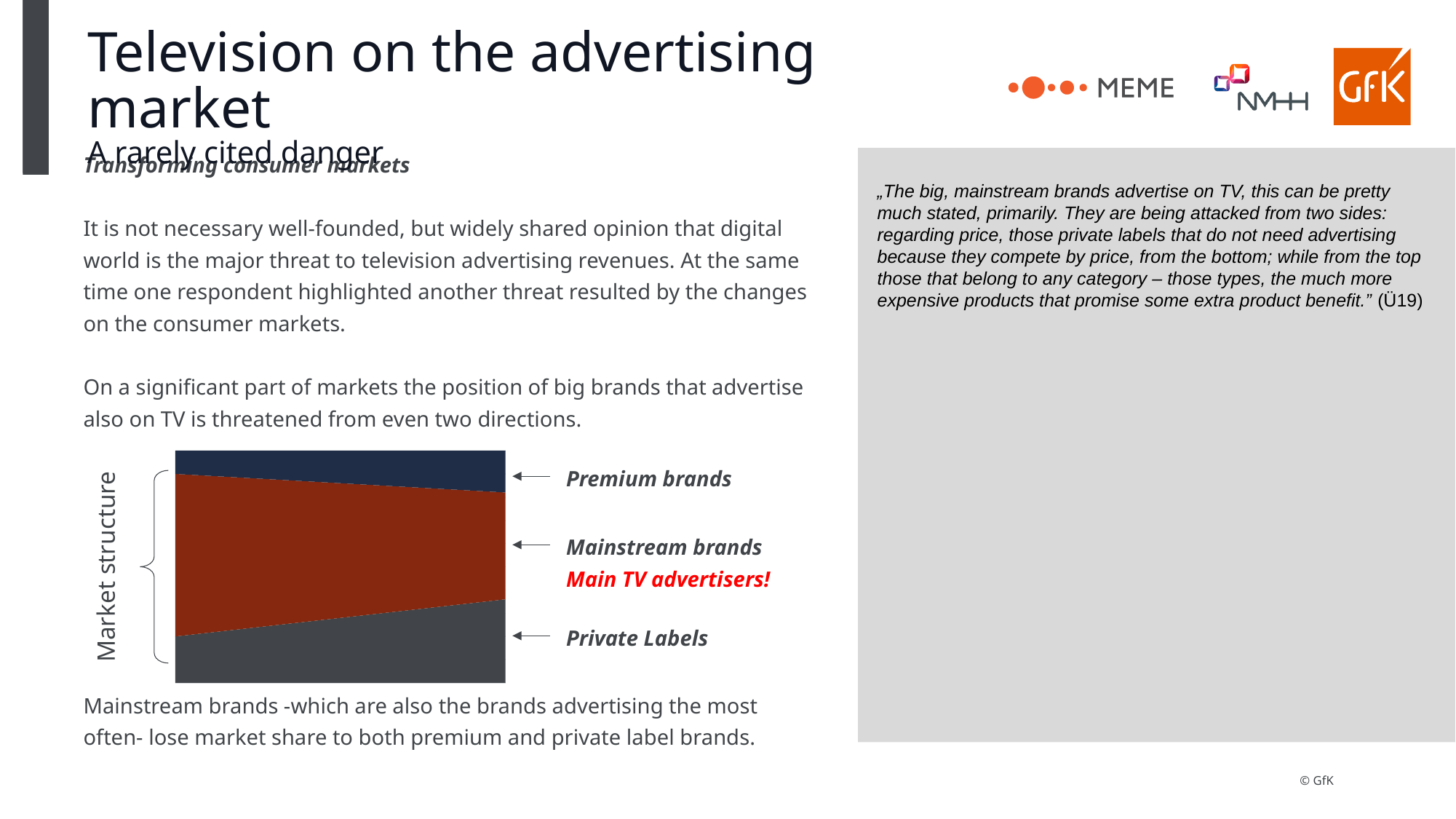
How many market segments does the market structure chart show? 3 Which segment occupies the largest area in the market structure chart? Mainstream brands Does the Mainstream brands segment widen or narrow from left to right in the market structure chart? narrow What is the label on the vertical axis of the chart? Market structure Which segment of the market structure chart is identified as the main TV advertisers? Mainstream brands Which segment is labelled at the top of the market structure chart? Premium brands Which is larger in the market structure chart, the Mainstream brands segment or the Premium brands segment? Mainstream brands Which segment is labelled at the bottom of the market structure chart? Private Labels What kind of chart is the market structure diagram? stacked area chart Does the Premium brands segment widen or narrow from left to right in the market structure chart? widen Does the Private Labels segment widen or narrow from left to right in the market structure chart? widen